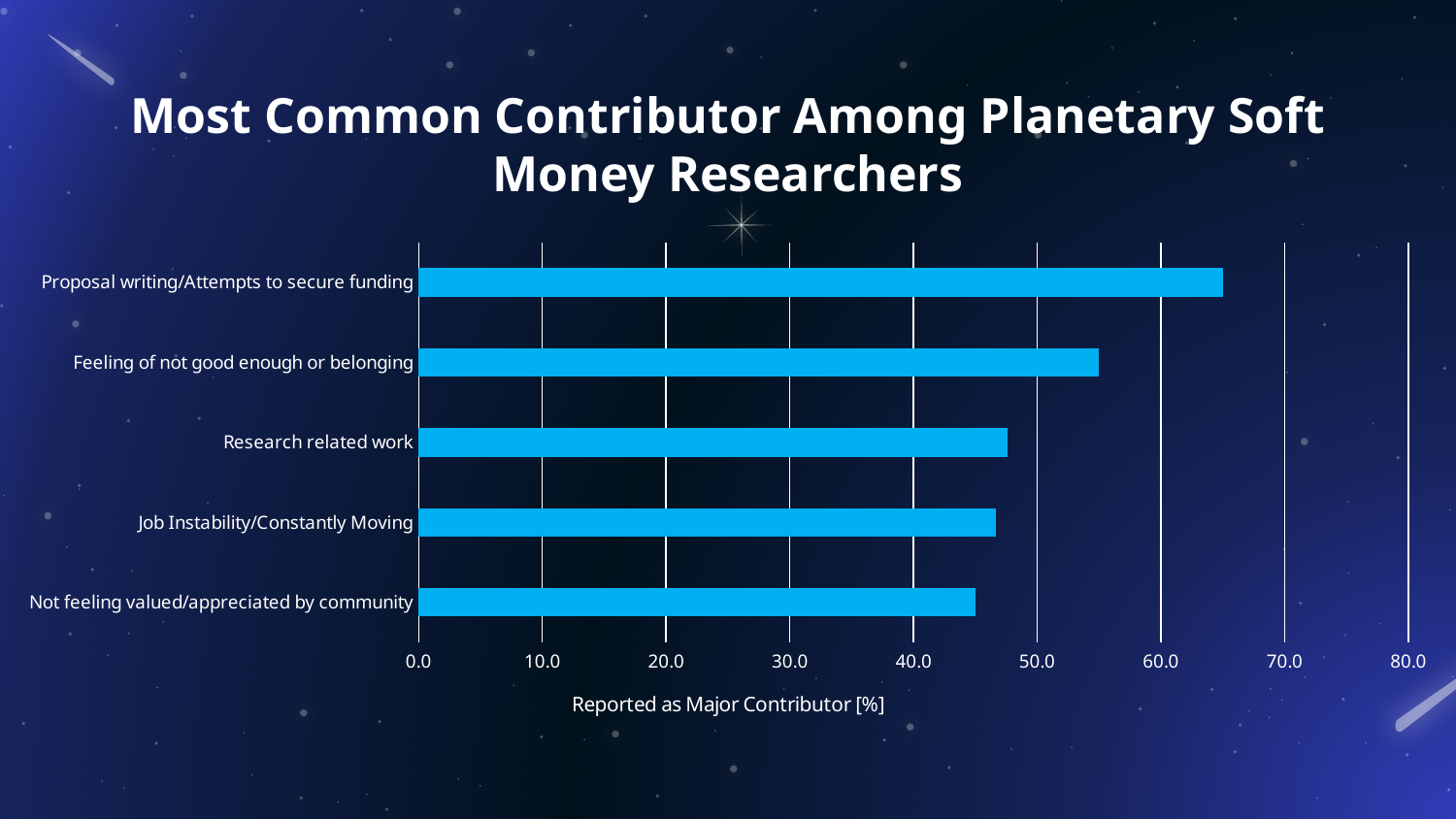
Is the value for Not feeling valued/appreciated by community greater or less than 40.0? greater What type of chart is shown on the slide? Bar chart Is the value for Research related work greater or less than 50.0? less Is the value for Job Instability/Constantly Moving greater or less than 50.0? less What is the title of the chart? Most Common Contributor Among Planetary Soft Money Researchers Which is larger: the value for Proposal writing/Attempts to secure funding or the value for Feeling of not good enough or belonging? Proposal writing/Attempts to secure funding What is the label on the horizontal axis of the chart? Reported as Major Contributor [%] How many categories are plotted in the chart? 5 Which is larger: the value for Feeling of not good enough or belonging or the value for Research related work? Feeling of not good enough or belonging Which category has the highest value in the chart? Proposal writing/Attempts to secure funding